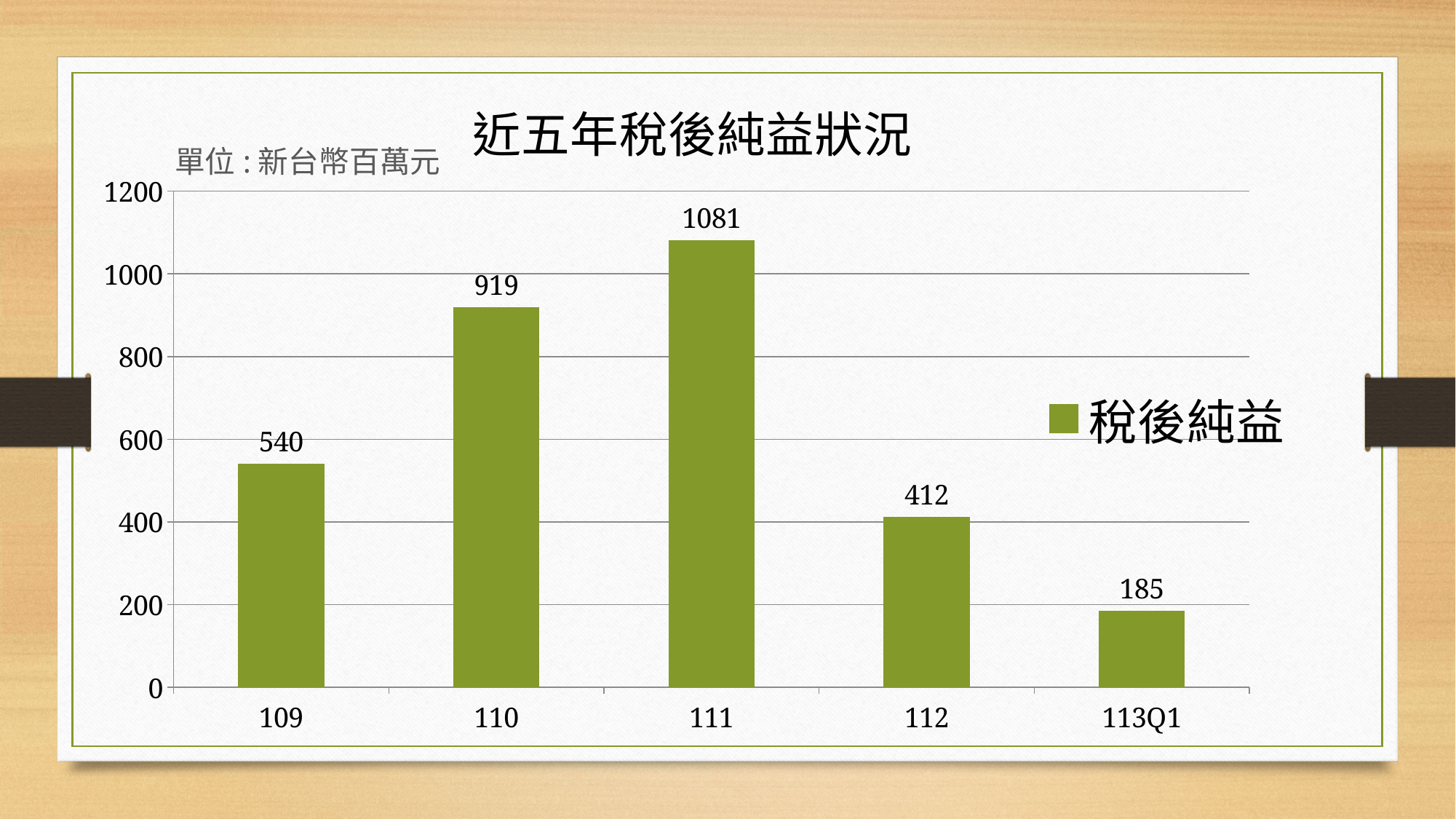
Which category has the lowest value? 113Q1 What is the value for 113Q1? 185 What is the difference between the values for 111 and 110? 162 Which is larger, the value for 110 or the value for 112? 110 How many categories are shown on the x axis? 5 What is the value for 111? 1081 What is the difference between the values for 109 and 112? 128 What is the title of the chart? 近五年稅後純益狀況 What kind of chart is this? bar chart How many series does the legend list? 1 Which category has the highest value? 111 What is the value for 109? 540